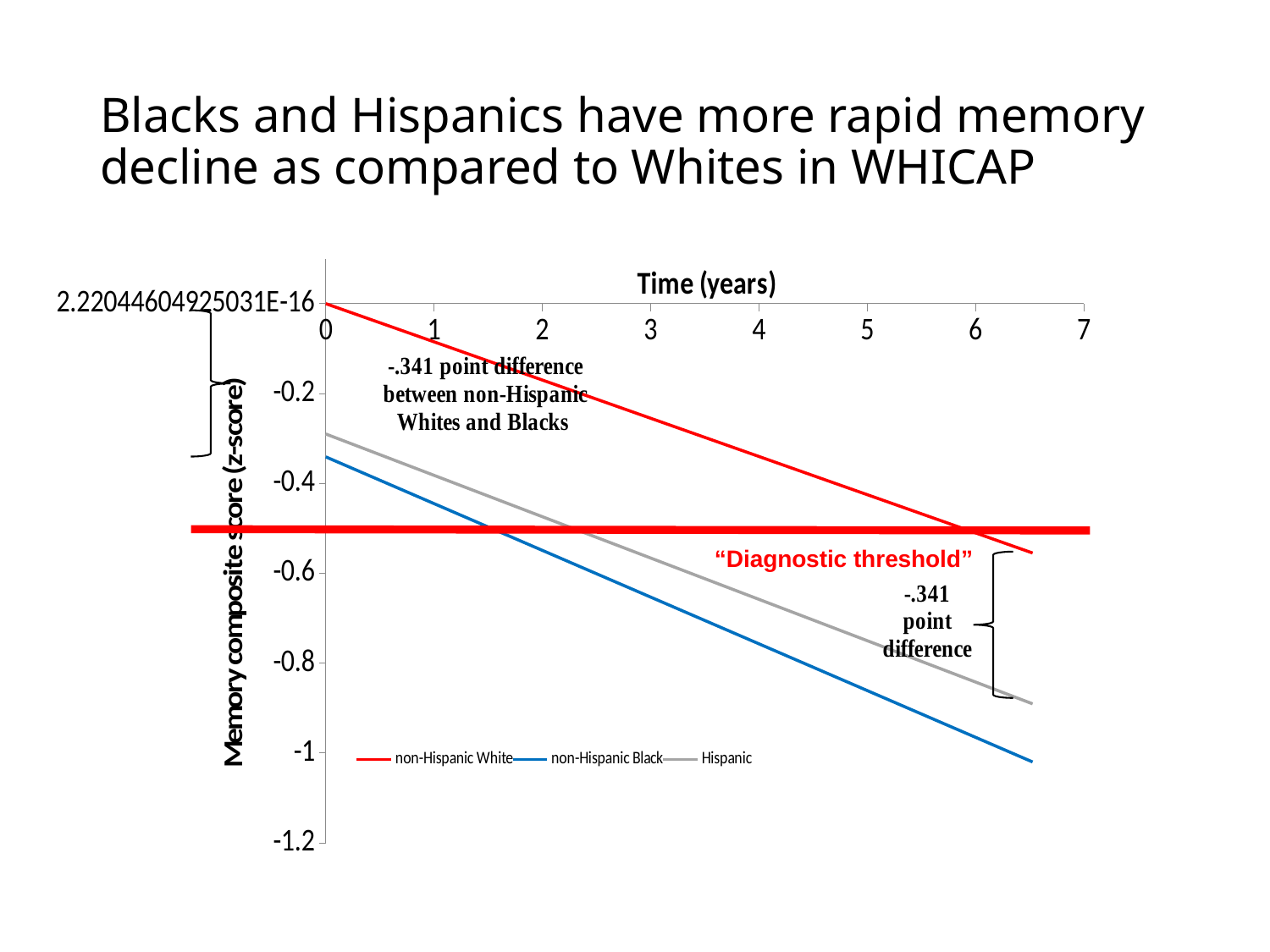
What kind of chart is shown on the slide? line chart Is the value for non-Hispanic Black at year 6 greater or less than -0.8? less Which series has the highest memory composite score at time 0? non-Hispanic White Do the memory composite scores rise or fall as time increases? fall At time 0, which series has the higher memory composite score, non-Hispanic White or non-Hispanic Black? non-Hispanic White At year 6, which series has the higher memory composite score, Hispanic or non-Hispanic Black? Hispanic How many series does the legend list? 3 Is the value for Hispanic at year 6 greater or less than -1? greater Which series has the lowest memory composite score at year 6? non-Hispanic Black Is the value for non-Hispanic White at year 3 greater or less than -0.4? greater What is the title of the x axis? Time (years) Which series is plotted in red? non-Hispanic White